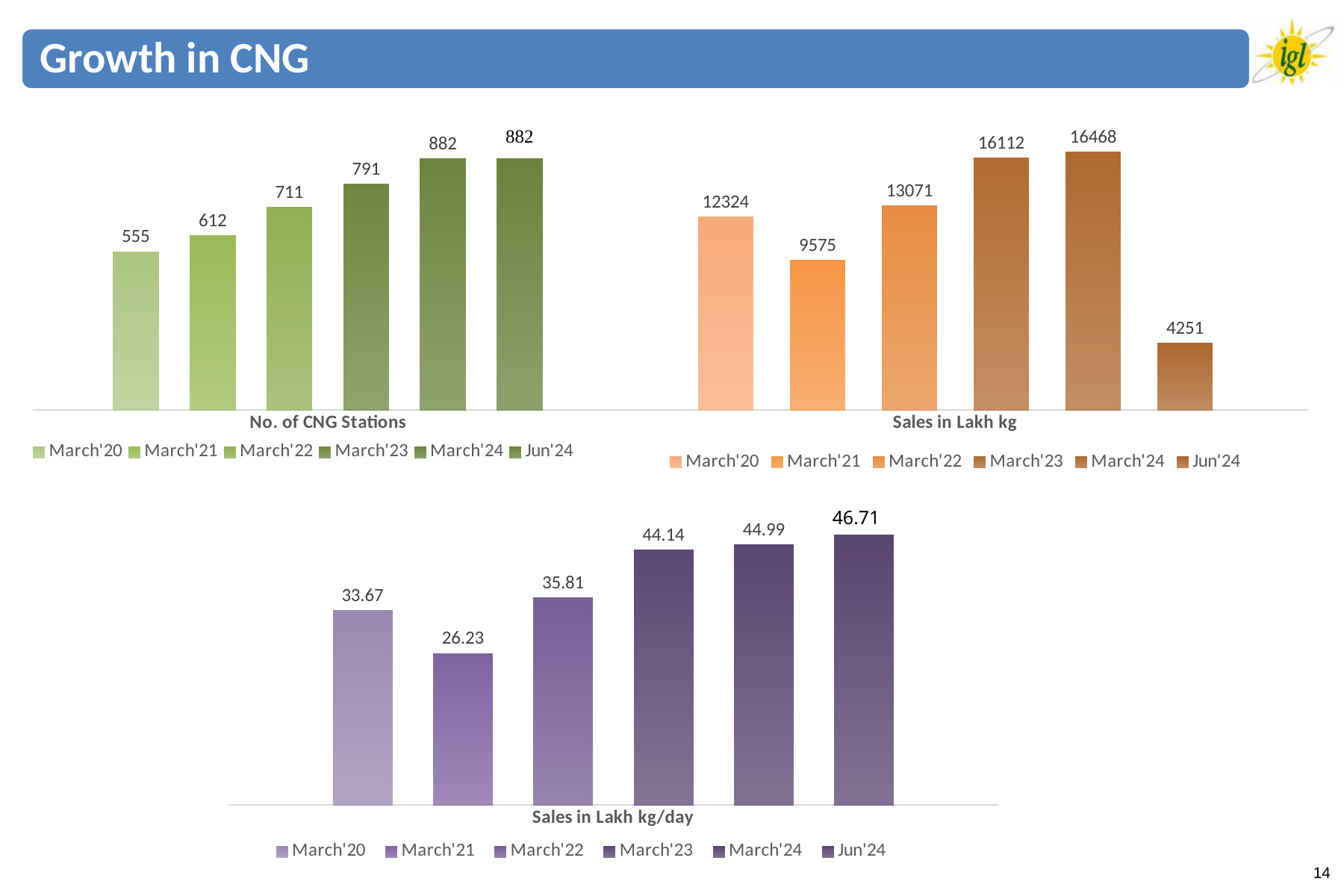
In the 'Sales in Lakh kg/day' chart, which is larger, March'22 or March'20? March'22 In the 'No. of CNG Stations' chart, what is the difference between March'23 and March'22? 80 In the 'Sales in Lakh kg/day' chart, what is the value for Jun'24? 46.71 In the 'Sales in Lakh kg' chart, what is the value for March'24? 16468 In the 'Sales in Lakh kg' chart, which period has the lowest value? Jun'24 What type of chart is the 'Sales in Lakh kg' chart? Bar chart In the 'No. of CNG Stations' chart, what is the value for March'22? 711 In the 'Sales in Lakh kg' chart, what is the difference between March'23 and March'21? 6537 In the 'No. of CNG Stations' chart, what is the value for March'20? 555 In the 'Sales in Lakh kg/day' chart, which period has the lowest value? March'21 How many entries does the legend of the 'No. of CNG Stations' chart list? 6 How many bars are plotted in the 'Sales in Lakh kg/day' chart? 6